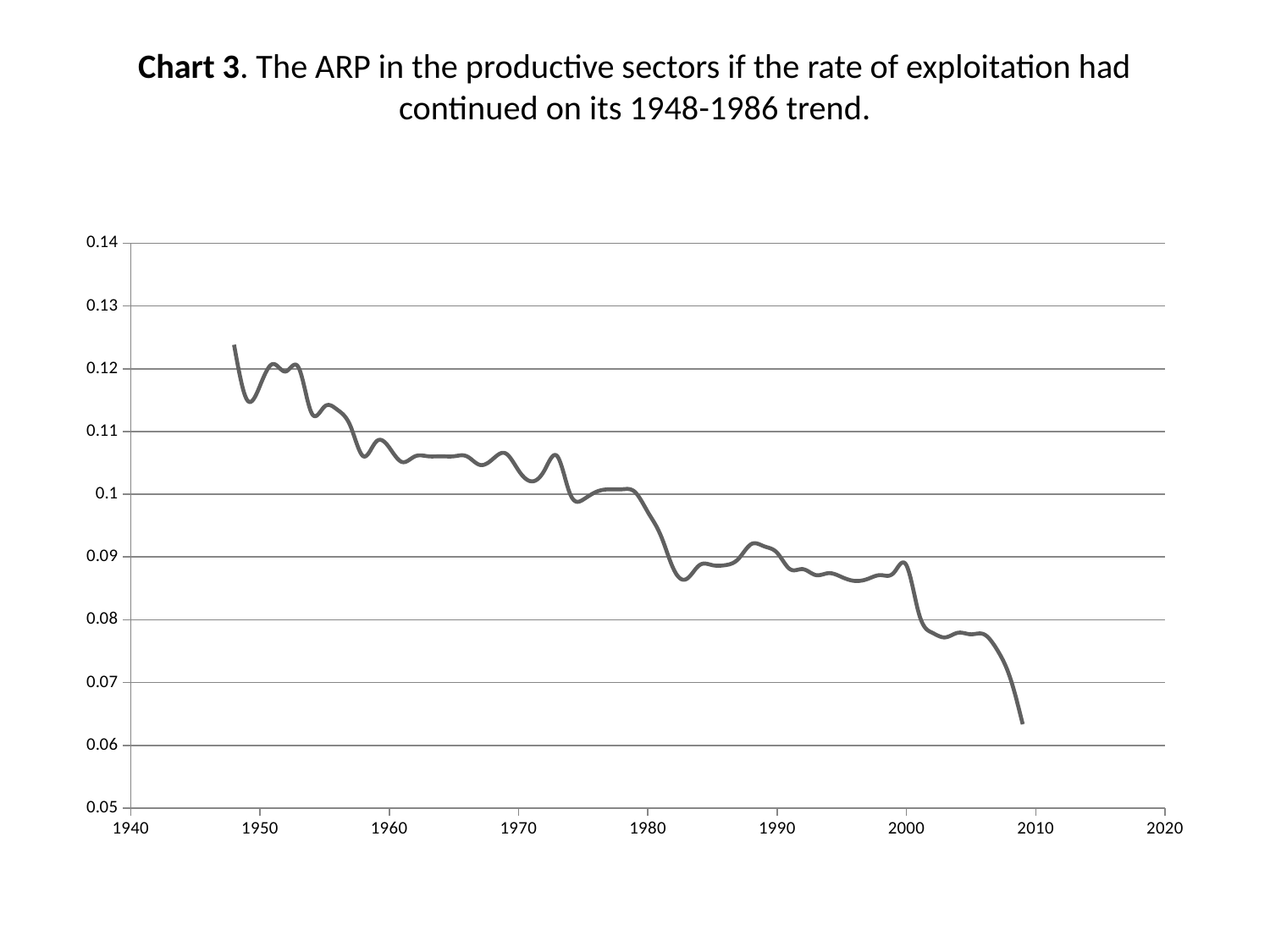
What kind of chart is shown on the slide? line chart Is the value at 2009 greater or less than 0.07? less Is the value at 2000 greater or less than 0.08? greater Is the value at 1948 greater or less than 0.12? greater In which year does the line reach its lowest value? 2009 Which year has the higher value, 1960 or 1990? 1960 What is the highest value shown on the vertical axis? 0.14 Which year has the higher value, 1948 or 2009? 1948 What is the title of the chart? Chart 3. The ARP in the productive sectors if the rate of exploitation had continued on its 1948-1986 trend. Overall, do the values rise or fall from 1948 to 2009? fall